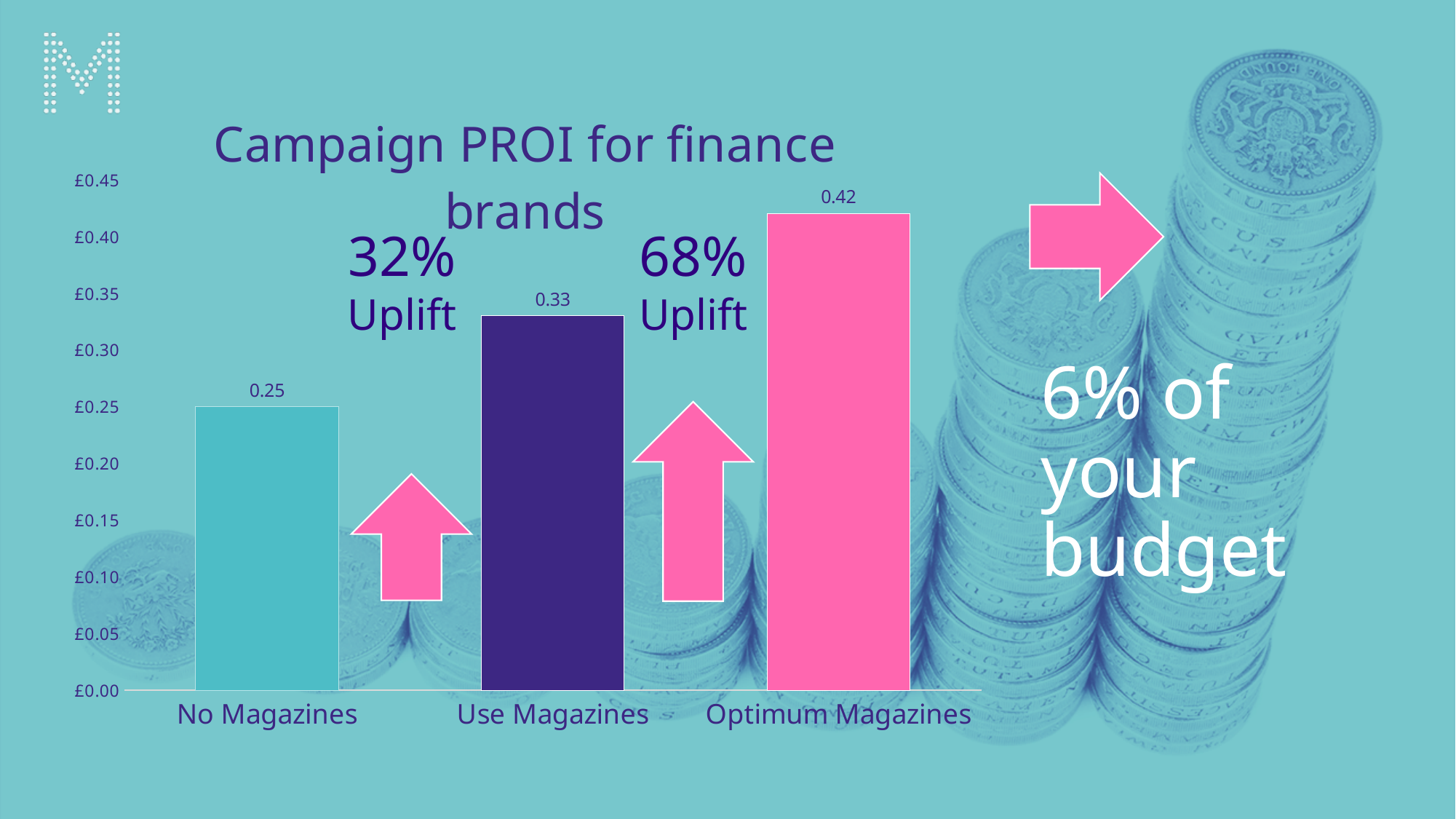
What is the title of the chart? Campaign PROI for finance brands Is the value for Optimum Magazines greater or less than £0.40? greater Which category has the highest value? Optimum Magazines What is the difference between the values for Use Magazines and No Magazines? 0.08 What is the value for Use Magazines? 0.33 What is the difference between the values for Optimum Magazines and No Magazines? 0.17 What kind of chart is shown on the slide? bar chart Which is larger, the value for Use Magazines or the value for Optimum Magazines? Optimum Magazines How many categories are shown on the x axis? 3 What is the value for No Magazines? 0.25 What is the value for Optimum Magazines? 0.42 Which category has the lowest value? No Magazines